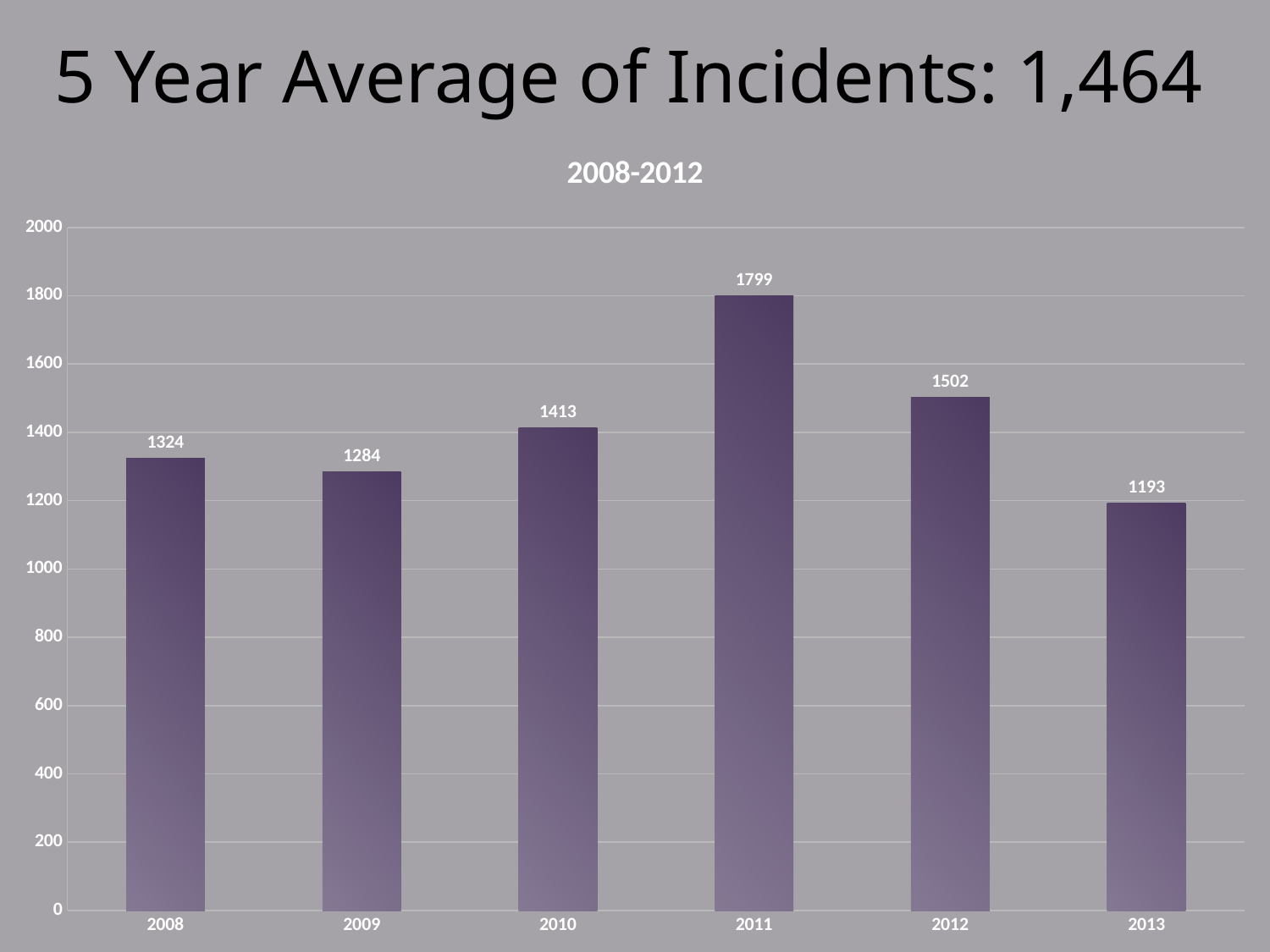
What kind of chart is shown on the slide? bar chart How many years are shown on the chart? 6 Which year has the lowest value? 2013 What is the difference between the values for 2008 and 2009? 40 What is the value for 2009? 1284 What is the difference between the values for 2011 and 2012? 297 What is the value for 2011? 1799 Is the value for 2012 greater or less than 1400? greater Which is larger, the value for 2010 or the value for 2012? 2012 What is the value for 2013? 1193 Which year has the highest value? 2011 What is the title of the chart? 2008-2012